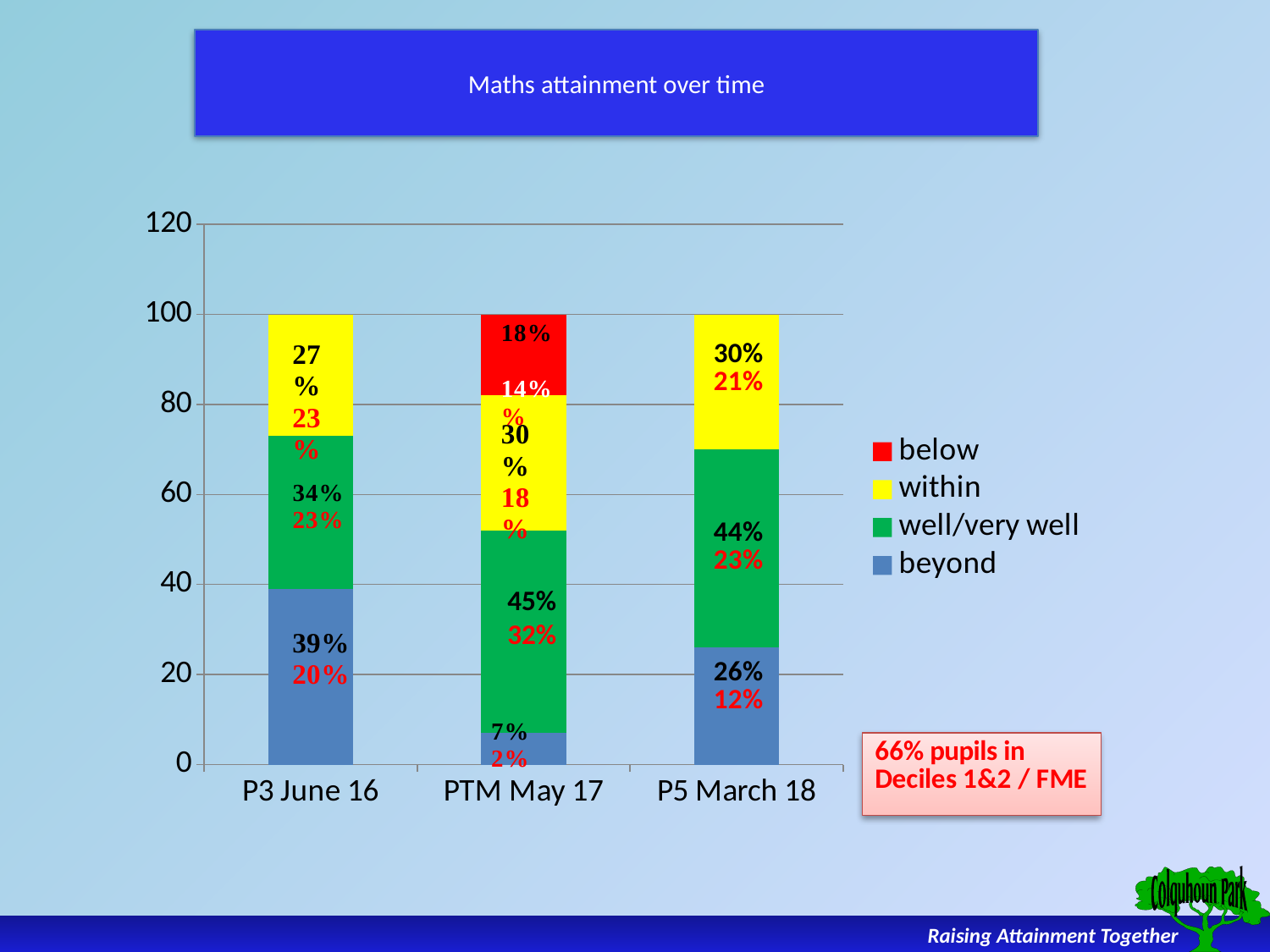
What is the black data label for the 'beyond' segment of P3 June 16? 39% What is the black data label for the 'below' segment of PTM May 17? 18% What kind of chart is shown on the slide? Stacked bar chart Which is larger, the 'within' segment for P3 June 16 or for PTM May 17 (black labels)? PTM May 17 What is the title of the chart? Maths attainment over time What is the black data label for the 'within' segment of P5 March 18? 30% Which category has the smallest 'beyond' segment? PTM May 17 How many categories are shown on the x axis of the chart? 3 What is the black data label for the 'well/very well' segment of PTM May 17? 45% How many series does the chart's legend list? 4 Which colour represents 'below' in the legend? Red Which category has the largest 'beyond' segment? P3 June 16